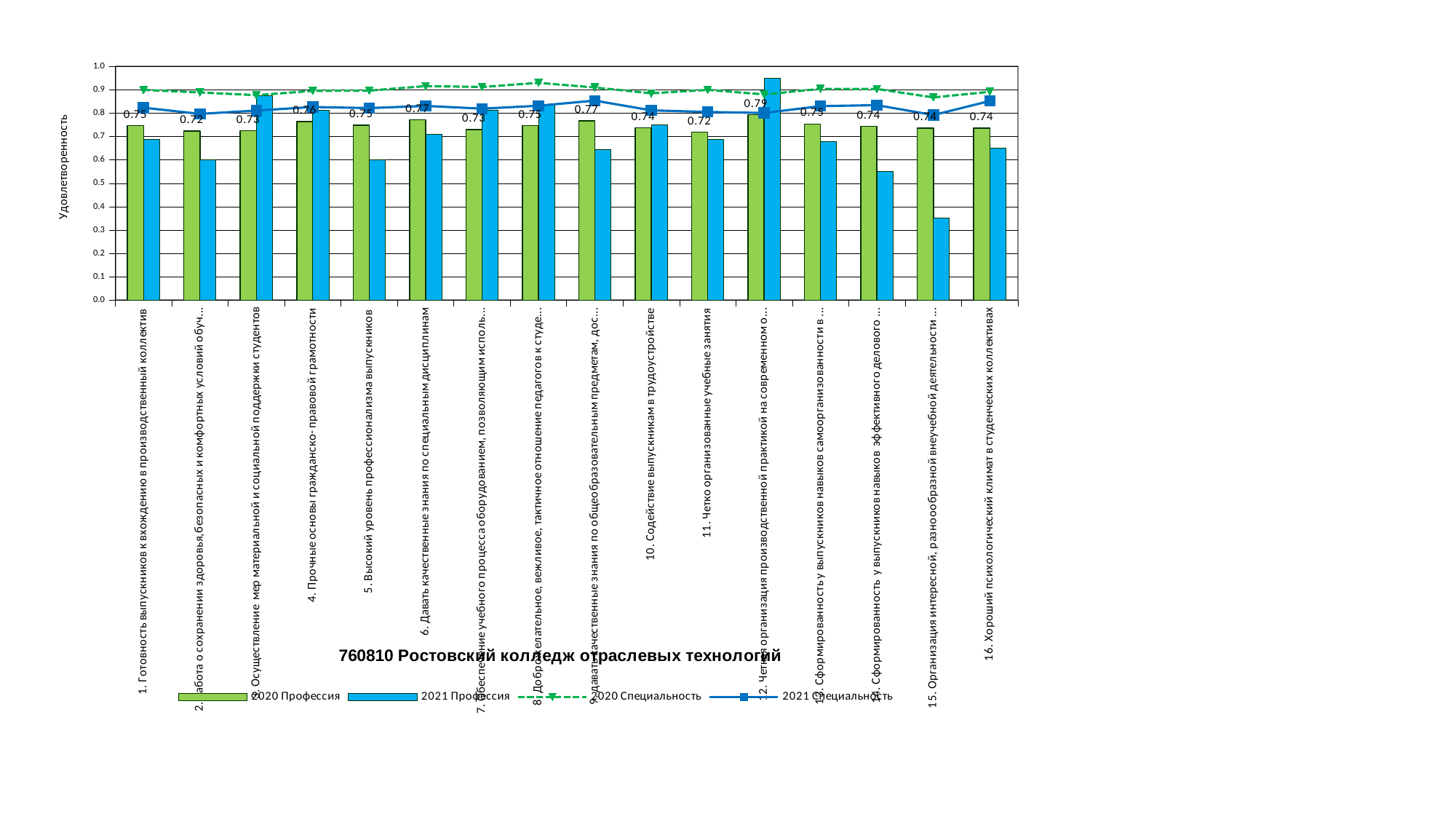
How many categories are shown along the x axis of the chart? 16 What is the 2020 Профессия value for category 16 (Хороший психологический климат в студенческих коллективах)? 0.74 Which category has the highest 2020 Профессия value? 12. Четкая организация производственной практикой на современном о... What is the 2020 Профессия value for category 4 (Прочные основы гражданско-правовой грамотности)? 0.76 What is the lowest 2020 Профессия value shown on the chart? 0.72 Is the 2021 Профессия value for category 15 (Организация интересной, разнообразной внеучебной деятельности...) greater or less than 0.4? less What type of chart is shown on the slide? Combined bar and line chart How many series does the chart legend list? 4 What is the title of the chart? 760810 Ростовский колледж отраслевых технологий What is the difference between the 2020 Профессия values for category 12 and category 11 (Четко организованные учебные занятия)? 0.07 For category 12, which is larger: the 2020 Профессия bar or the 2021 Профессия bar? 2021 Профессия What is the 2020 Профессия value for category 12 (Четкая организация производственной практикой...)? 0.79